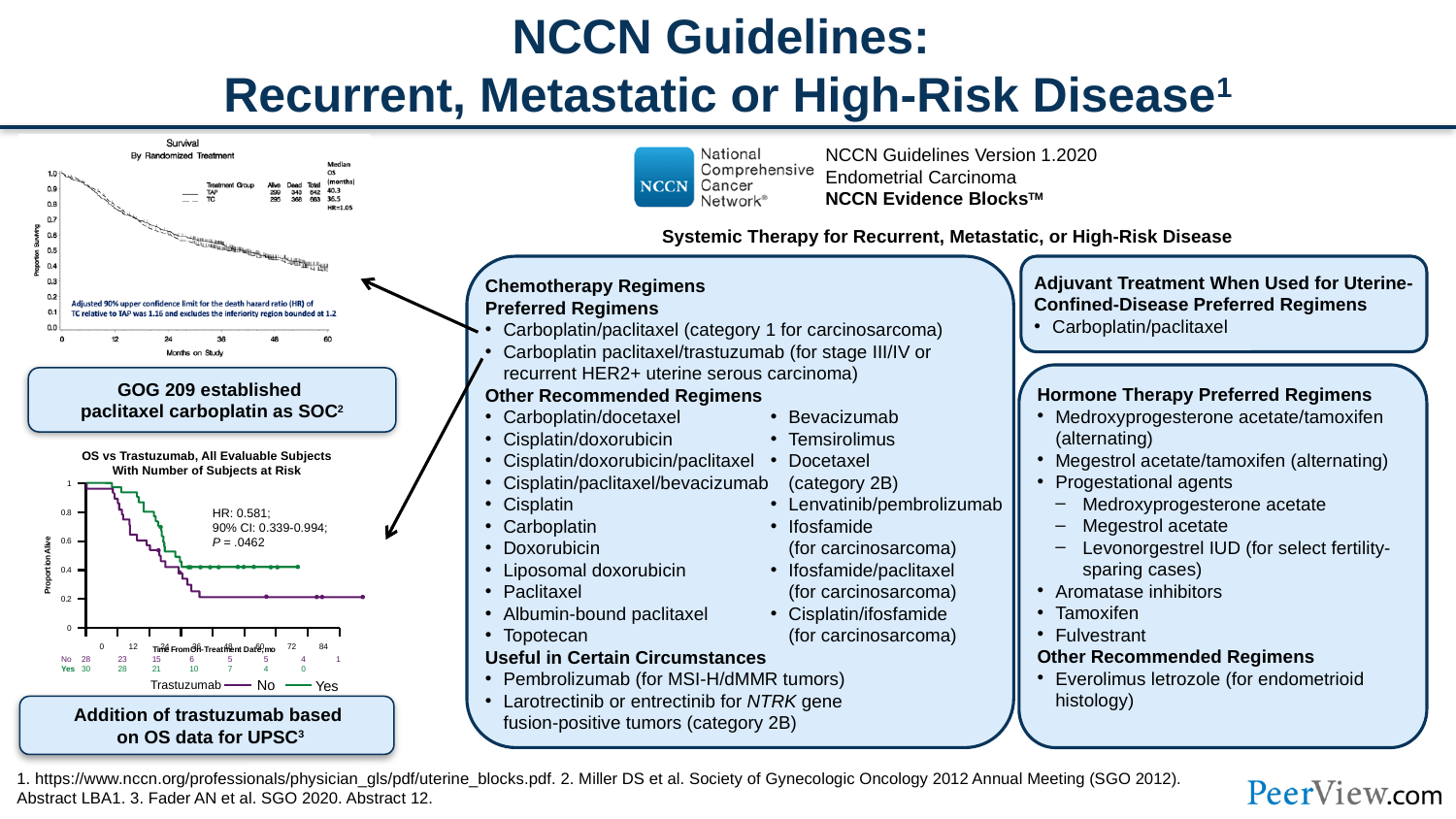
In the 'OS vs Trastuzumab' chart, is the proportion alive for the Trastuzumab 'No' group at 48 months greater or less than 0.4? less In the 'OS vs Trastuzumab' chart, does the proportion alive rise or fall as time from on-treatment date increases? fall In the 'Survival By Randomized Treatment' chart at the top left, what is the median OS in months for the TAP group? 40.3 What kind of chart is the 'OS vs Trastuzumab' chart at the bottom left of the slide? line chart In the 'OS vs Trastuzumab' chart, which group has the higher proportion alive at 48 months, Trastuzumab 'Yes' or 'No'? Yes In the 'OS vs Trastuzumab' chart, how many subjects are at risk at time 0 in the Trastuzumab 'No' group? 28 In the 'OS vs Trastuzumab' chart, what is the difference in the number of subjects at risk at time 0 between the 'Yes' and 'No' groups? 2 In the 'OS vs Trastuzumab' chart, what is the 90% CI shown? 0.339-0.994 In the 'OS vs Trastuzumab' chart, what hazard ratio (HR) is printed? 0.581 In the 'OS vs Trastuzumab' chart, what P value is printed? .0462 In the 'OS vs Trastuzumab' chart, how many subjects are at risk at time 0 in the Trastuzumab 'Yes' group? 30 In the 'OS vs Trastuzumab' chart, how many series does the legend list? 2